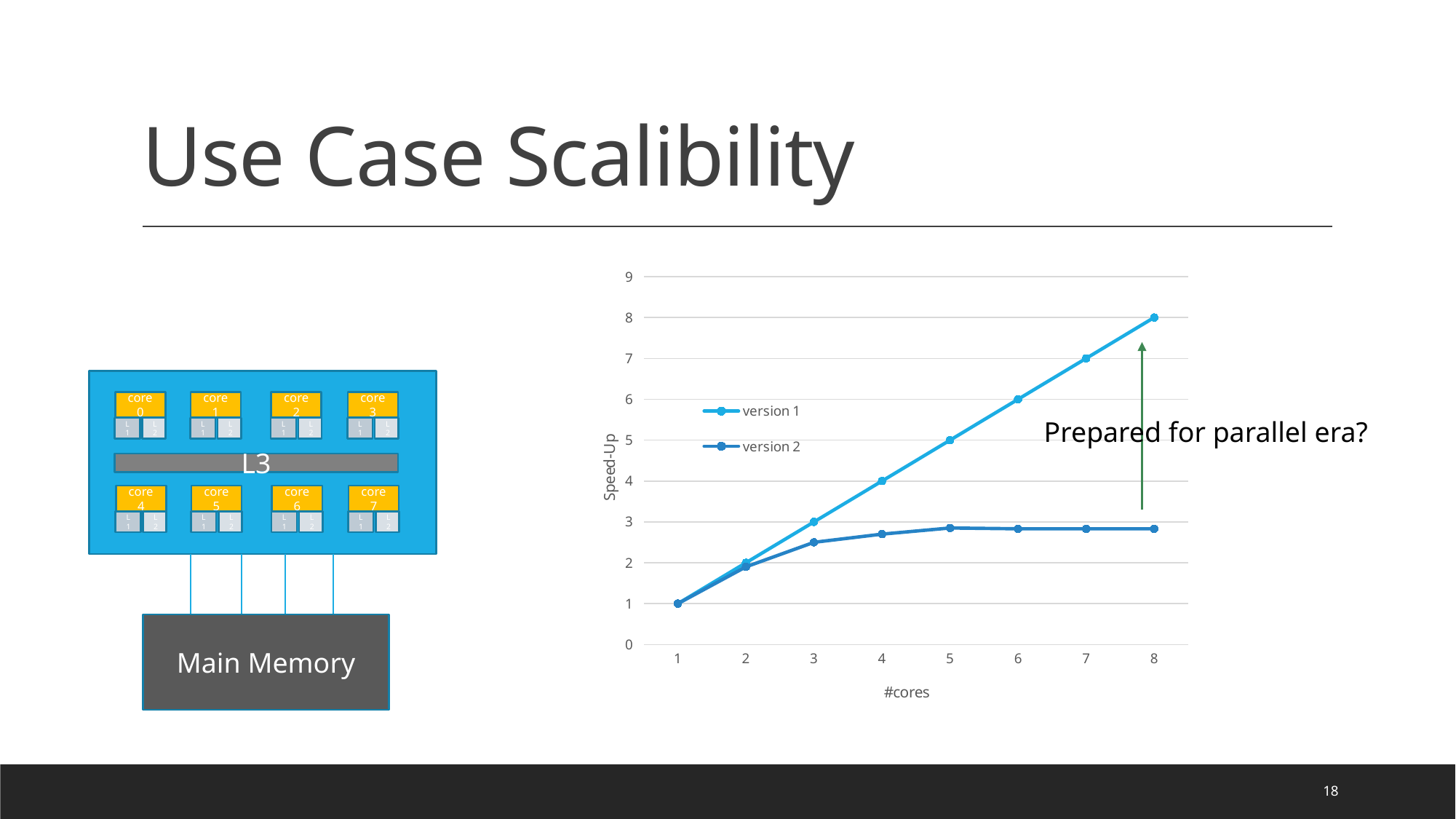
What kind of chart is shown on the slide? line chart Is the Speed-Up for version 2 at 8 cores greater or less than 3? less Is the Speed-Up for version 2 at 3 cores greater or less than 2? greater What is the Speed-Up for version 1 at 4 cores? 4 How many series does the chart legend list? 2 What is the difference in Speed-Up for version 1 between 8 cores and 1 core? 7 What is the Speed-Up for version 1 at 8 cores? 8 Does the Speed-Up for version 1 rise or fall as the number of cores increases? rise How many #cores values are plotted along the x axis? 8 Which series has the higher Speed-Up at 8 cores, version 1 or version 2? version 1 What are the names of the two series in the legend? version 1 and version 2 What is the Speed-Up for version 2 at 1 core? 1